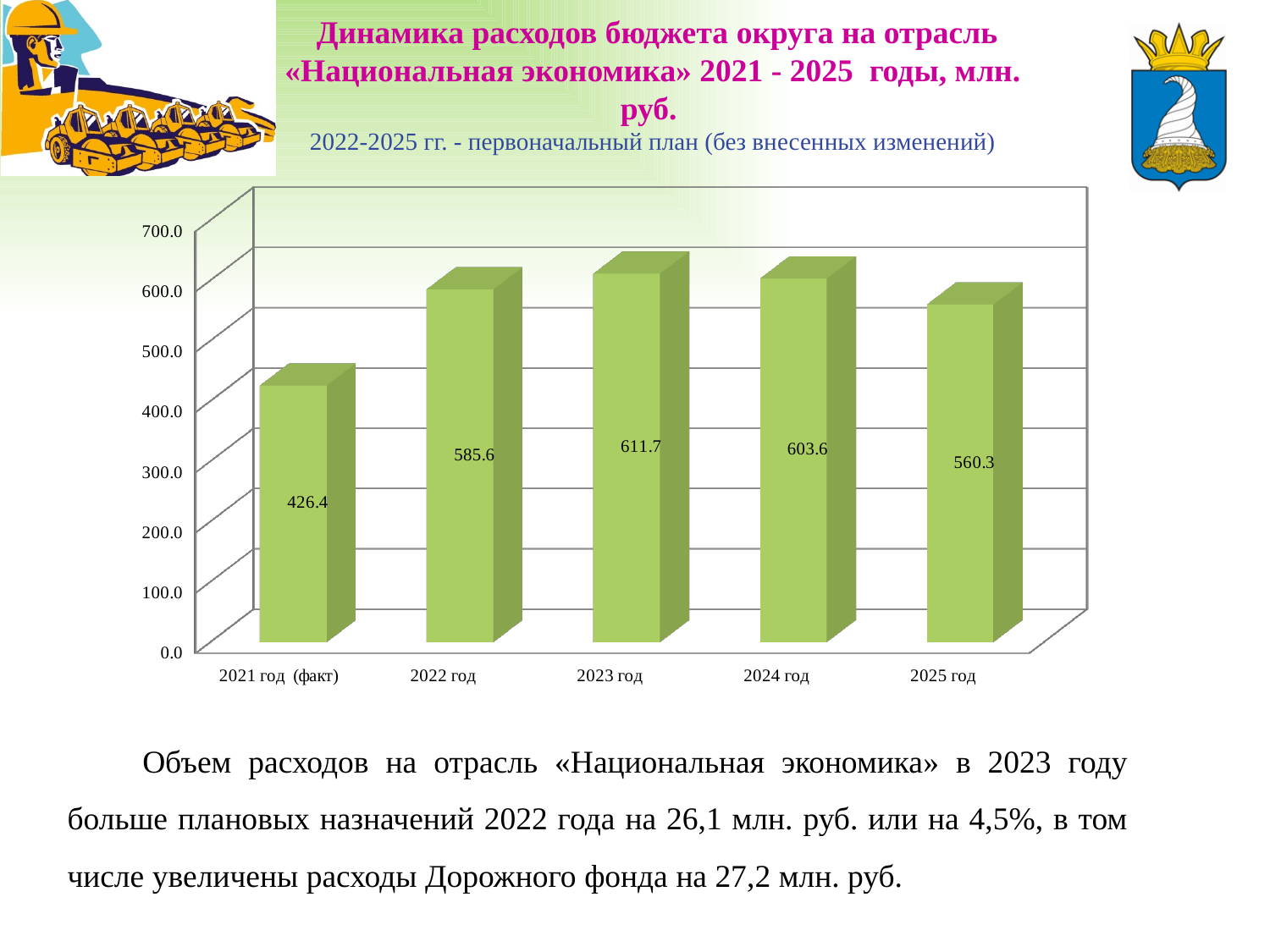
What is the value for 2025 год? 560.3 Which year has the lowest value? 2021 год (факт) Is the value for 2024 год greater or less than 500.0? greater Which year has the highest value? 2023 год Do the values rise or fall from 2023 год to 2025 год? fall How many years are shown on the chart? 5 What is the value for 2023 год? 611.7 Which is larger, the value for 2022 год or the value for 2021 год (факт)? 2022 год What kind of chart is shown on the slide? bar chart What is the difference between the values for 2024 год and 2025 год? 43.3 What is the difference between the values for 2023 год and 2022 год? 26.1 What is the value for 2021 год (факт)? 426.4